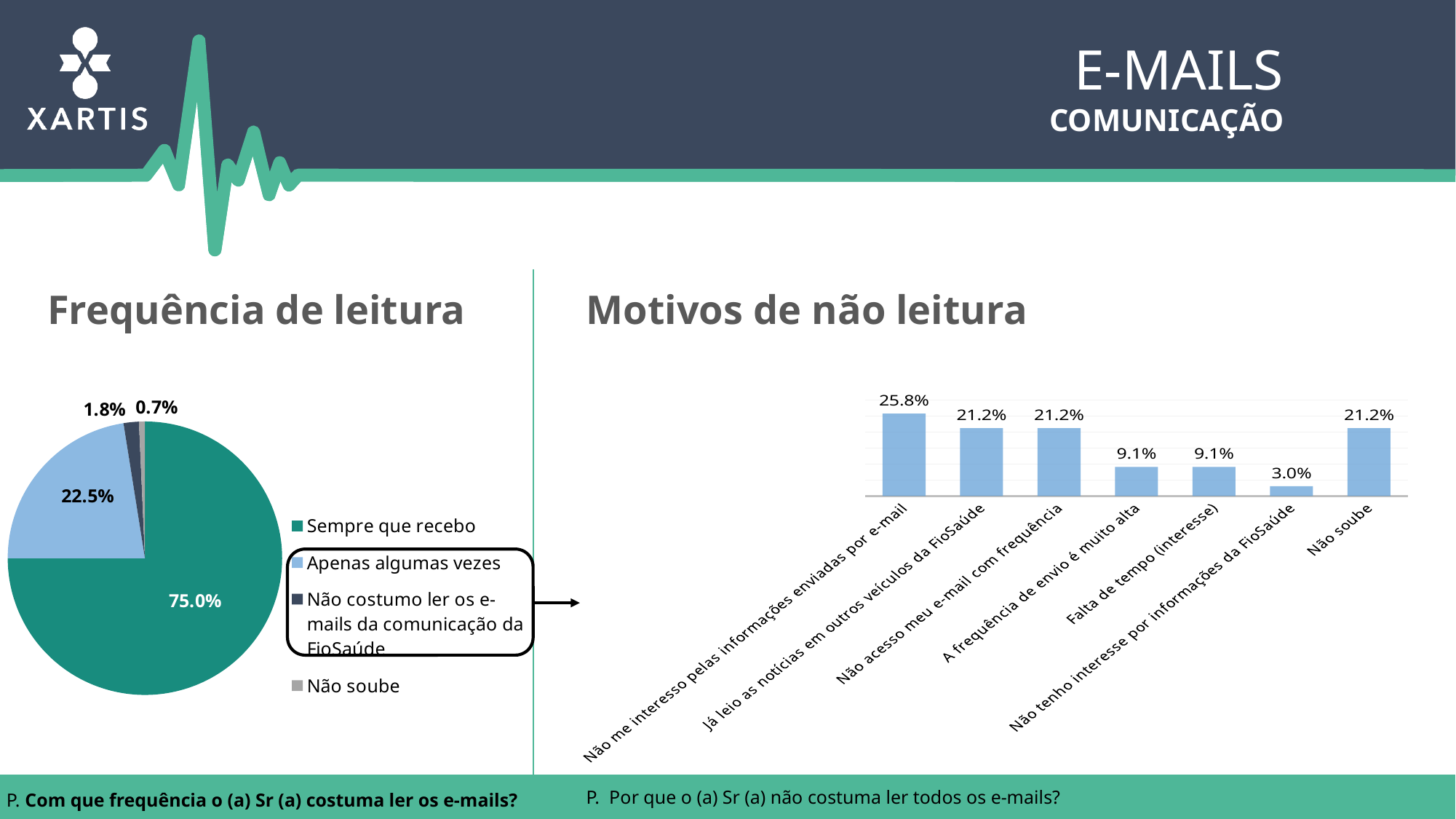
In the 'Frequência de leitura' pie chart, how many categories does the legend list? 4 What kind of chart is used for 'Motivos de não leitura'? Bar chart In the 'Motivos de não leitura' chart, what is the value for 'A frequência de envio é muito alta'? 9.1% In the 'Frequência de leitura' pie chart, what is the difference between 'Sempre que recebo' and 'Apenas algumas vezes'? 52.5% In the 'Motivos de não leitura' chart, what is the value for 'Não me interesso pelas informações enviadas por e-mail'? 25.8% In the 'Frequência de leitura' pie chart, which category has the smallest slice? Não soube In the 'Motivos de não leitura' chart, which category has the highest value? Não me interesso pelas informações enviadas por e-mail What kind of chart is used for 'Frequência de leitura'? Pie chart In the 'Motivos de não leitura' chart, which category has the lowest value? Não tenho interesse por informações da FioSaúde In the 'Frequência de leitura' pie chart, what share is shown for 'Sempre que recebo'? 75.0% In the 'Motivos de não leitura' chart, how many categories are plotted? 7 In the 'Frequência de leitura' pie chart, what share is shown for 'Apenas algumas vezes'? 22.5%